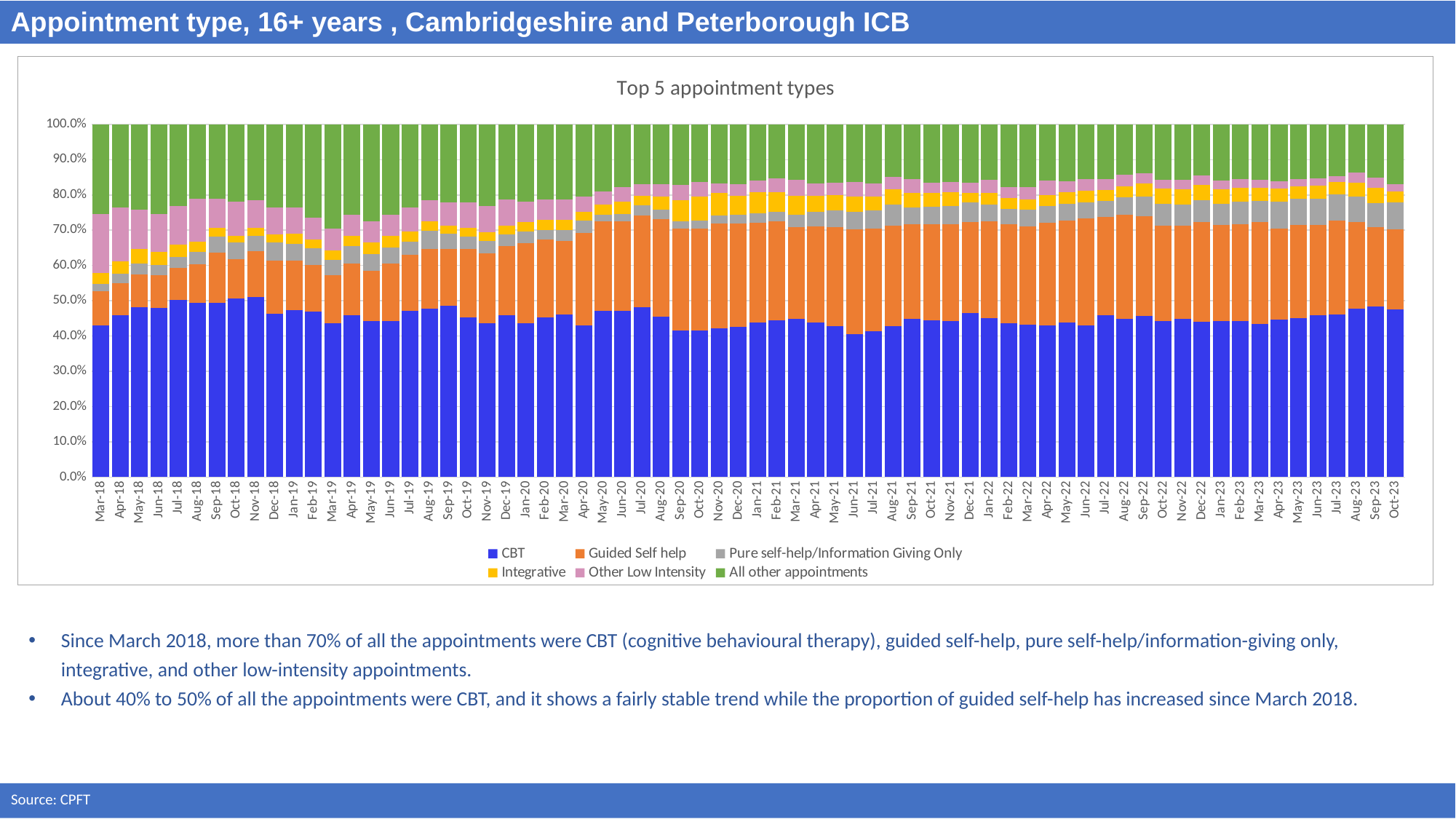
What is the total of each stacked bar in the chart? 100.0% What is the title of the chart? Top 5 appointment types Does the share of Guided Self help rise or fall from Mar-18 to Oct-23? rise Which series is shown in blue in the legend? CBT What kind of chart is shown on the slide? Stacked bar chart Does the share of Other Low Intensity appointments rise or fall from Mar-18 to Oct-23? fall How many series does the legend list? 6 Is the CBT share for Oct-23 greater or less than 50.0%? less What is the first month shown on the x axis? Mar-18 How many months are plotted along the x axis, from Mar-18 to Oct-23? 68 Is the CBT share for Mar-18 greater or less than 40.0%? greater Is the CBT share for Jun-21 greater or less than 50.0%? less